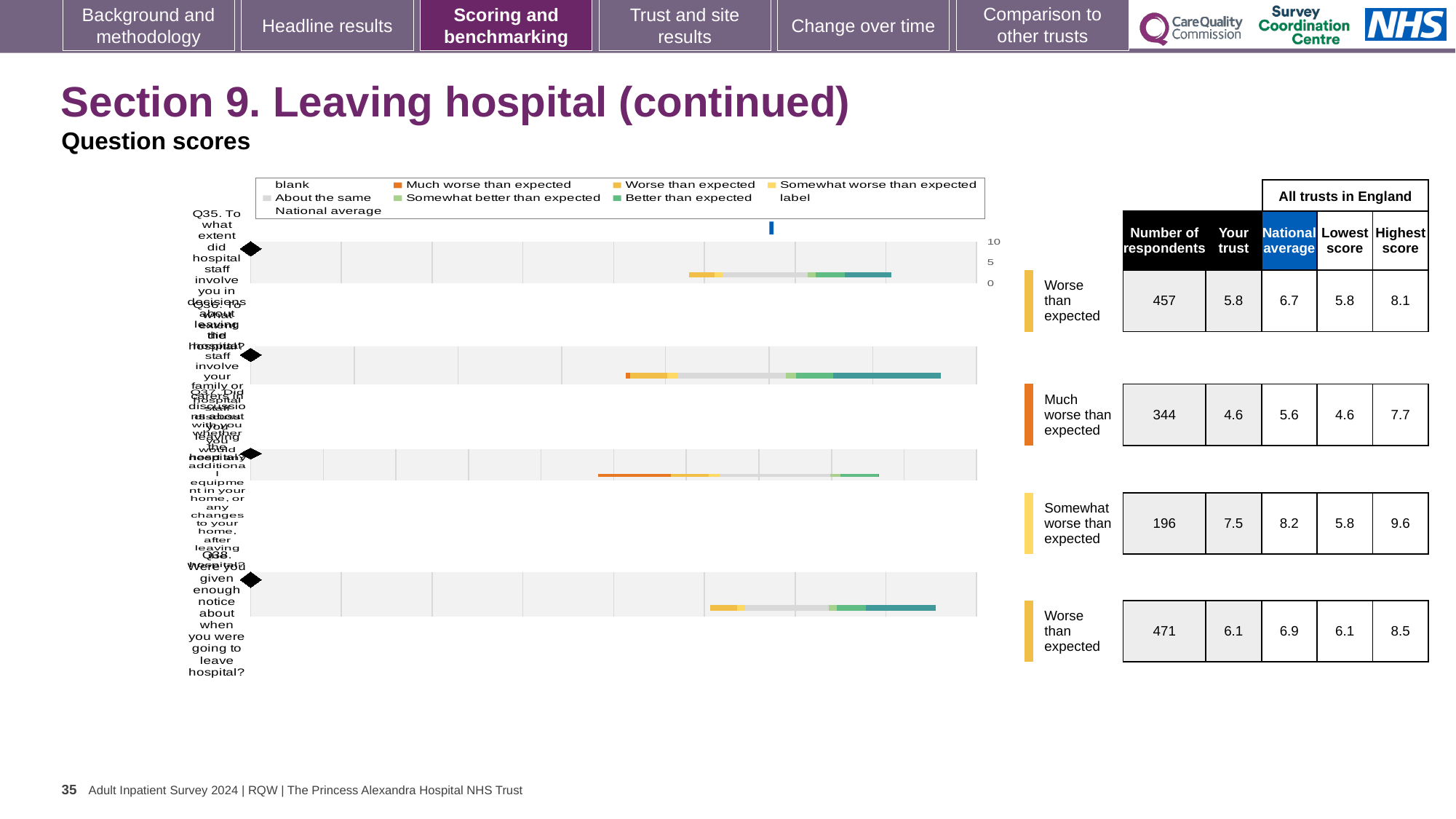
Which has the larger 'Your trust' score, Q35 or Q38? Q38 What kind of chart is used to show the question scores on this slide? bar chart For Q35, how much higher is the national average than the 'Your trust' score? 0.9 What is the 'Your trust' score for Q35 (To what extent did hospital staff involve you in decisions about leaving the hospital?)? 5.8 How many respondents answered Q36 (the second bar in the chart)? 344 What benchmark category is shown for Q36 (the second bar in the chart)? Much worse than expected What is the lowest score across all trusts in England for Q38? 6.1 What is the national average score for Q38 (Were you given enough notice about when you were going to leave hospital?)? 6.9 How many questions (bars) are plotted in the question scores chart? 4 What is the highest score across all trusts in England for Q37 (the third bar in the chart)? 9.6 Which question has the highest 'Your trust' score? Q37 Which question has the lowest 'Your trust' score? Q36